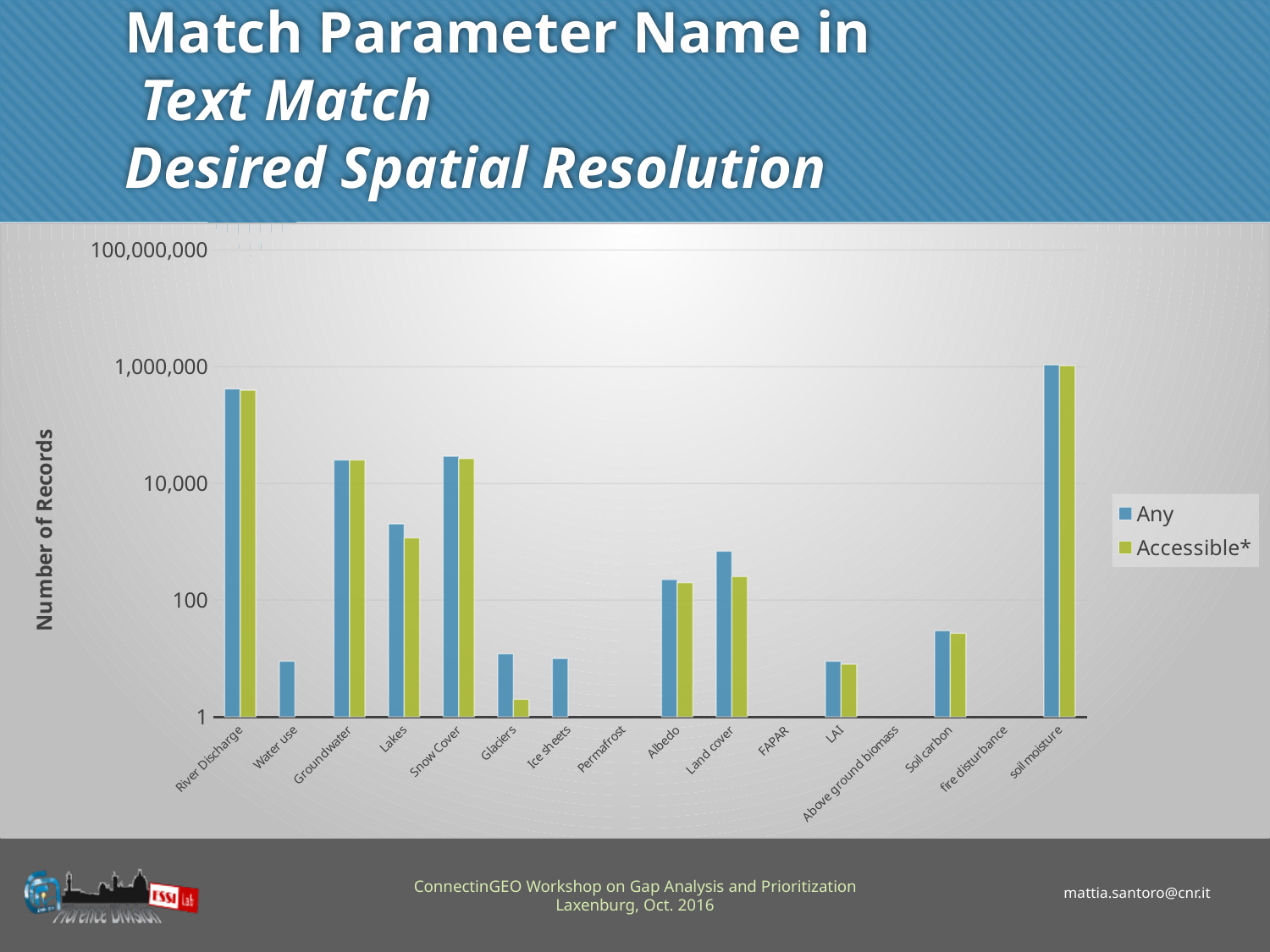
What are the two series named in the legend? Any and Accessible* What kind of chart is shown on the slide? bar chart How many series does the legend list? 2 Is the Any value for Groundwater greater or less than 10,000? greater Is the Any value for Lakes greater or less than 10,000? less For Lakes, which is larger: the Any value or the Accessible* value? Any Which category has the highest value for the Any series? soil moisture Is the Any value for River Discharge greater or less than 1,000,000? less What is the label of the vertical axis? Number of Records How many categories are shown along the x axis? 16 For Land cover, which is larger: the Any value or the Accessible* value? Any